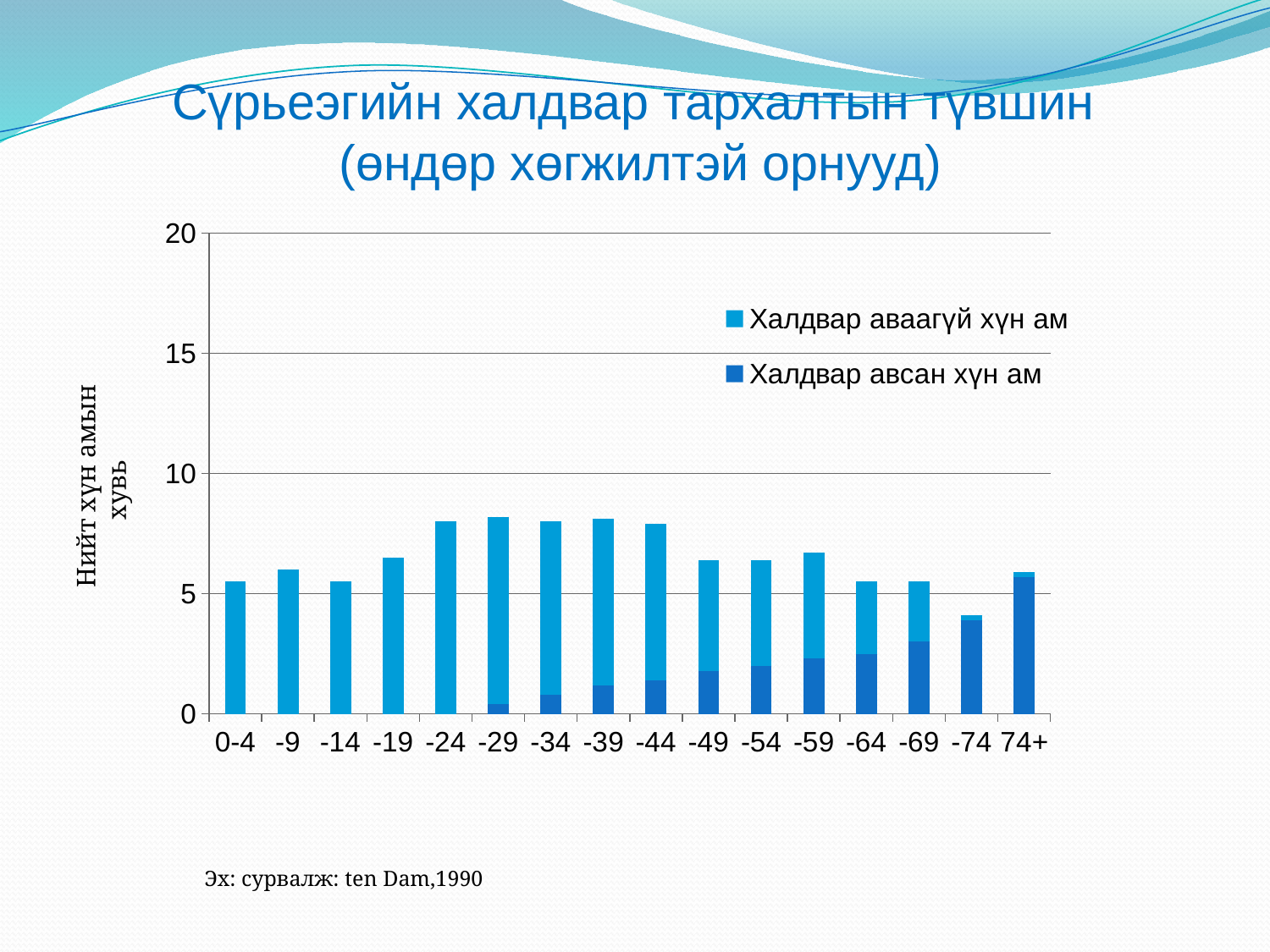
Which has the larger total bar height, the 0-4 age group or the -24 age group? -24 Is the total bar height for the -29 age group greater or less than 10? less Is the total bar height for the -74 age group greater or less than 5? less Which age group has the lowest total bar height? -74 Does the value for Халдвар авсан хүн ам rise or fall as age increases from -29 to 74+? rise How many age-group categories are shown on the x axis? 16 Which age group has the highest value for Халдвар авсан хүн ам? 74+ How many series does the legend list? 2 Is the total bar height for the -24 age group greater or less than 5? greater Which series is shown in dark blue according to the legend? Халдвар авсан хүн ам What kind of chart is shown on the slide? stacked bar chart What is the title of the chart on the slide? Сүрьеэгийн халдвар тархалтын түвшин (өндөр хөгжилтэй орнууд)